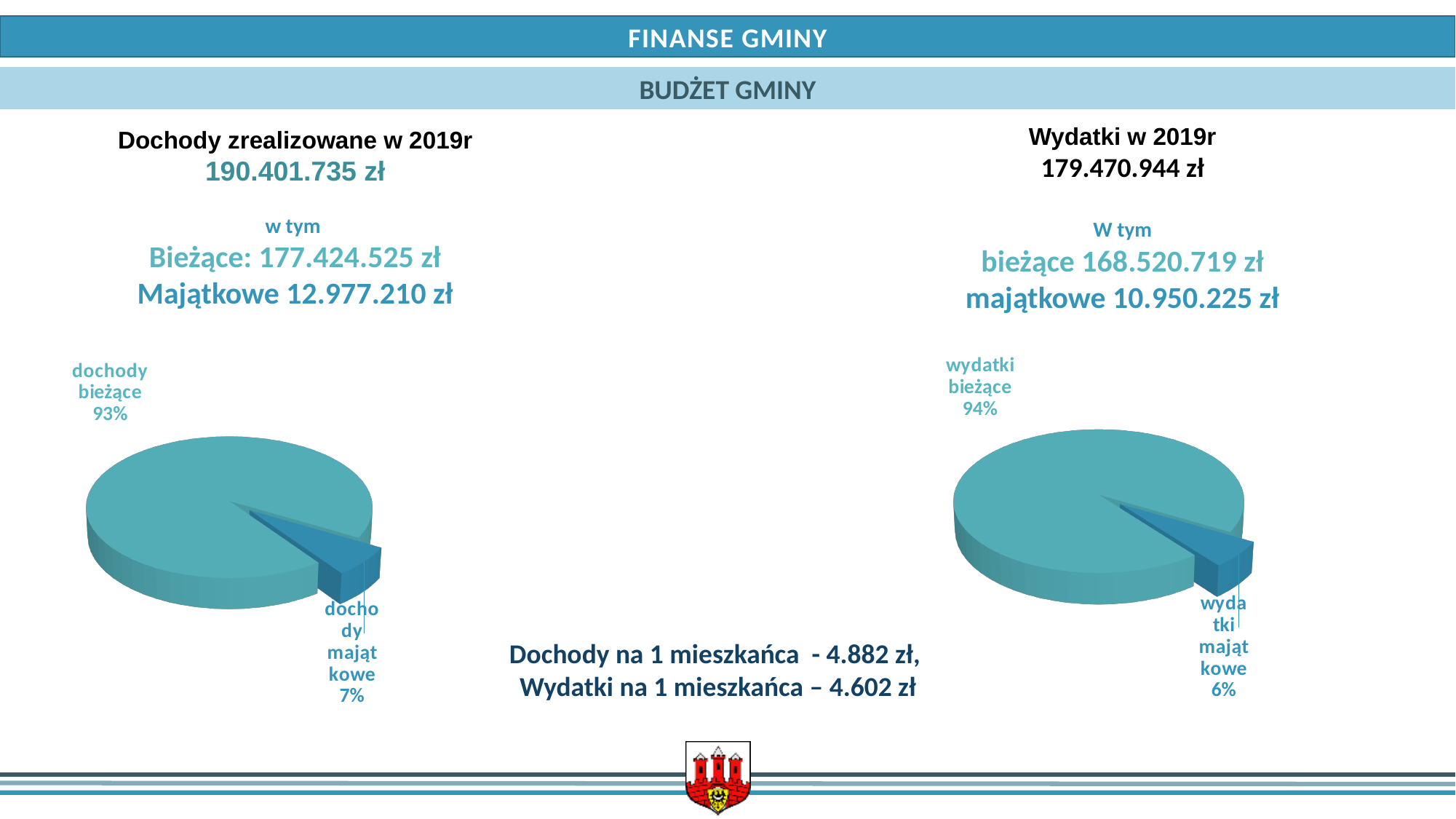
In the right pie chart, which slice is the smallest? wydatki majątkowe In the left pie chart, which slice is the largest? dochody bieżące What kind of chart is the right chart on the slide? pie chart In the left pie chart, what share is labelled for dochody bieżące? 93% How many slices does the left pie chart have? 2 Which is larger: the share of dochody majątkowe in the left pie chart or the share of wydatki majątkowe in the right pie chart? dochody majątkowe What kind of chart is the left chart on the slide? pie chart In the left pie chart, what is the difference in percentage points between dochody bieżące and dochody majątkowe? 86 In the right pie chart, what share is labelled for wydatki majątkowe? 6% In the right pie chart, what share is labelled for wydatki bieżące? 94% How many slices does the right pie chart have? 2